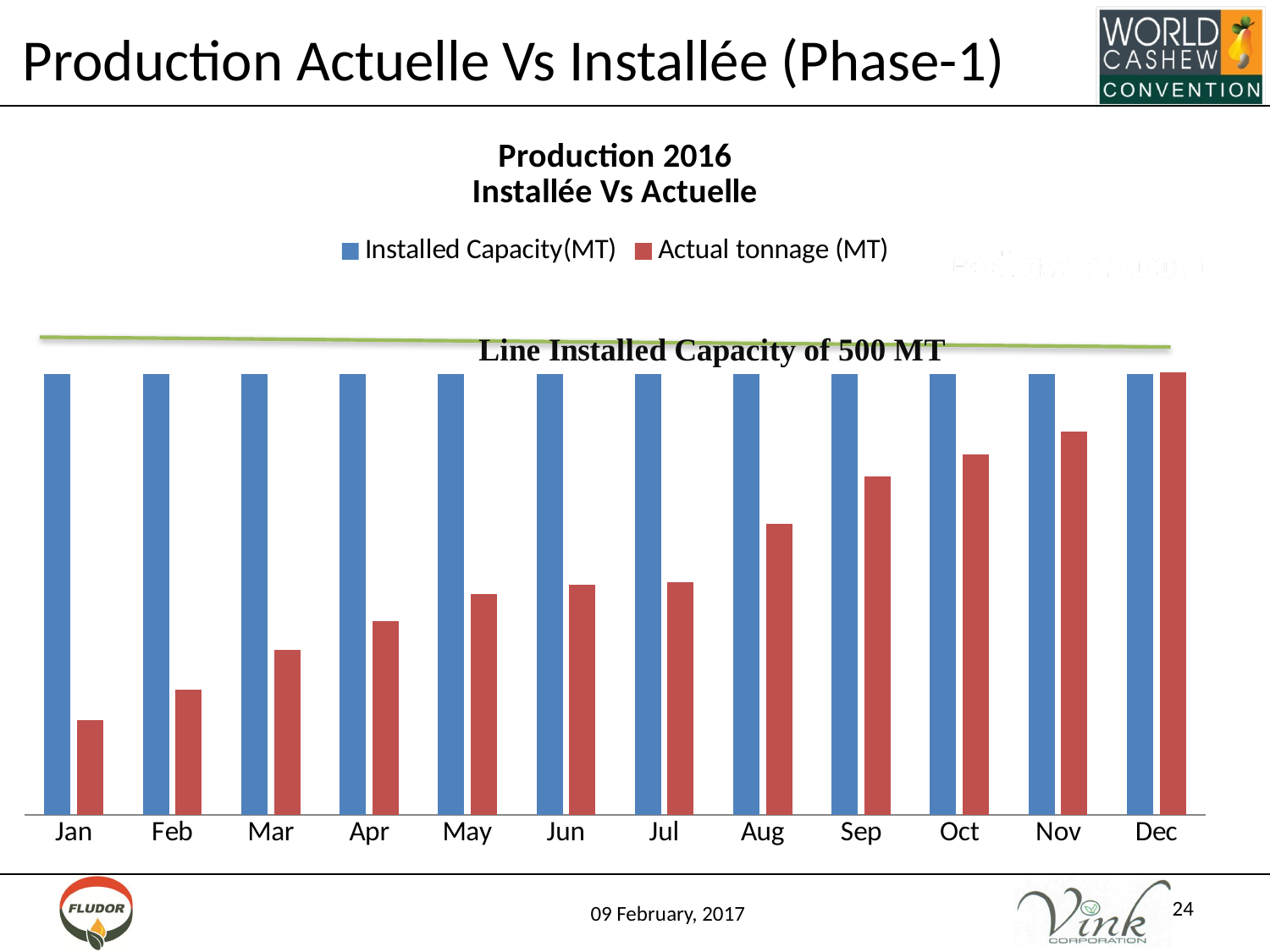
Which is larger, the Actual tonnage (MT) for Sep or for Apr? Sep Which colour represents Actual tonnage (MT) in the chart? Red Which is larger, the Actual tonnage (MT) for Nov or for Feb? Nov Does the Actual tonnage (MT) rise or fall from Jan to Dec? Rise What kind of chart is shown on the slide? Bar chart Which month has the highest Actual tonnage (MT)? Dec How many series does the legend list? 2 Which is larger in Jan, Installed Capacity(MT) or Actual tonnage (MT)? Installed Capacity(MT) How many months are shown on the x axis? 12 Which month has the lowest Actual tonnage (MT)? Jan What is the title of the chart? Production 2016 Installée Vs Actuelle